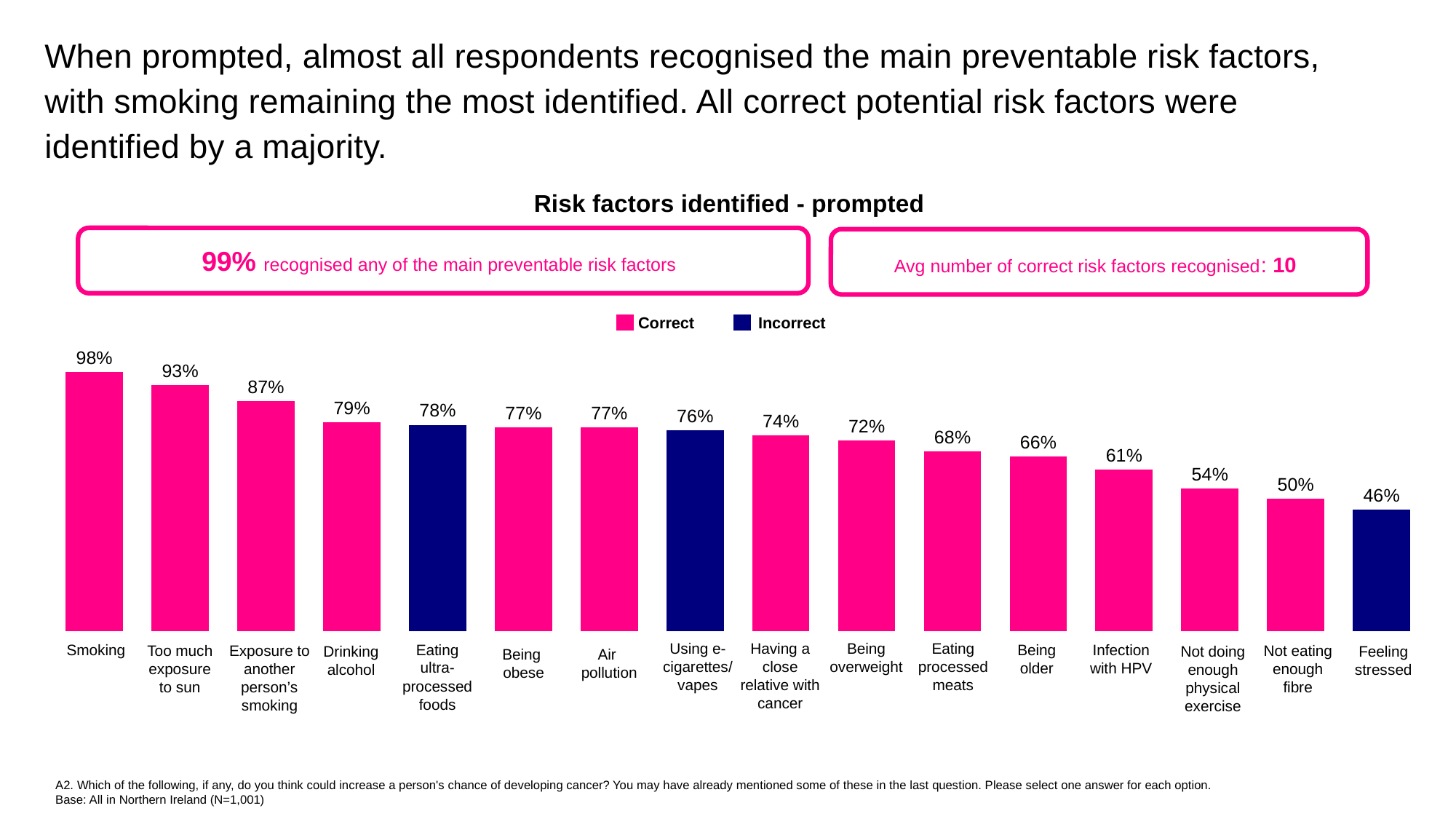
What is the value shown for Infection with HPV? 61% What percentage of respondents identified Smoking as a risk factor? 98% What is the difference between the values for Smoking and Feeling stressed? 52% How many risk factors (bars) are shown in the chart? 16 What kind of chart is shown on the slide? Bar chart Which risk factor has the lowest value in the chart? Feeling stressed Which colour is used for the Incorrect bars in the chart? Dark blue Which has a higher value, Being overweight or Eating processed meats? Being overweight How many series does the legend list? 2 What is the difference between the values for Drinking alcohol and Being older? 13% What is the value shown for Eating ultra-processed foods? 78% Which risk factor has the highest value in the chart? Smoking